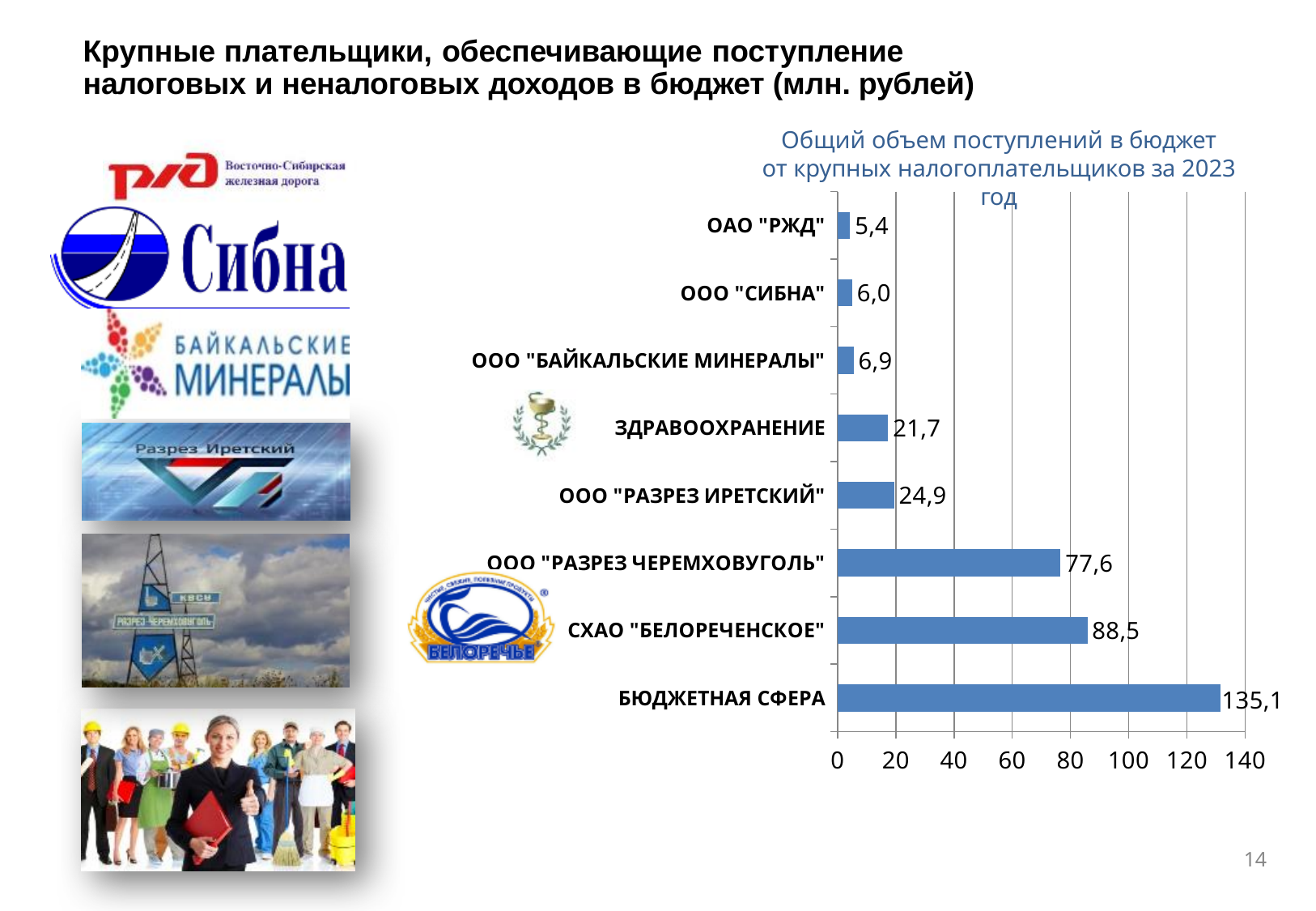
What is the difference between the values for СХАО "БЕЛОРЕЧЕНСКОЕ" and ООО "РАЗРЕЗ ЧЕРЕМХОВУГОЛЬ"? 10,9 Which category has the highest value? БЮДЖЕТНАЯ СФЕРА What is the title of the chart? Общий объем поступлений в бюджет от крупных налогоплательщиков за 2023 год What is the value for ЗДРАВООХРАНЕНИЕ? 21,7 What is the value for ООО "РАЗРЕЗ ЧЕРЕМХОВУГОЛЬ"? 77,6 What kind of chart is shown on the slide? bar chart What is the difference between the values for ООО "СИБНА" and ОАО "РЖД"? 0,6 What is the value for ОАО "РЖД"? 5,4 Is the value for БЮДЖЕТНАЯ СФЕРА greater or less than 120? greater How many categories are shown in the chart? 8 Which category has the lowest value? ОАО "РЖД" Which is larger: the value for ООО "РАЗРЕЗ ИРЕТСКИЙ" or the value for ЗДРАВООХРАНЕНИЕ? ООО "РАЗРЕЗ ИРЕТСКИЙ"